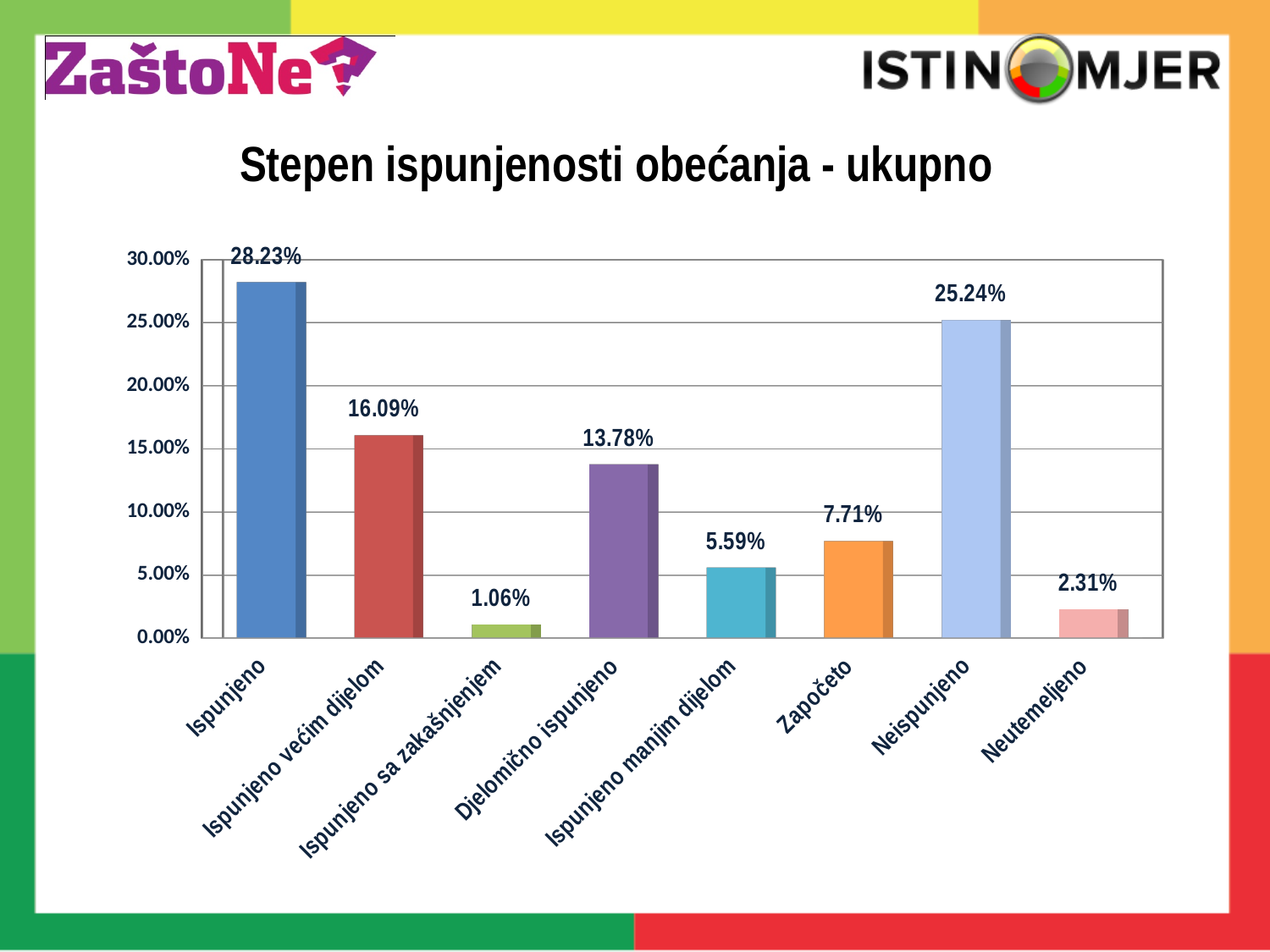
What is the title of the chart? Stepen ispunjenosti obećanja - ukupno What is the value for Ispunjeno? 28.23% Which is larger, the value for Ispunjeno većim dijelom or the value for Djelomično ispunjeno? Ispunjeno većim dijelom Which category has the lowest value? Ispunjeno sa zakašnjenjem What is the difference between the values for Ispunjeno and Neispunjeno? 2.99% How many categories are shown on the x axis? 8 What kind of chart is shown on the slide? bar chart Is the value for Ispunjeno manjim dijelom greater or less than 10.00%? less What is the value for Započeto? 7.71% Which category has the highest value? Ispunjeno What is the value for Ispunjeno sa zakašnjenjem? 1.06% What is the value for Neispunjeno? 25.24%